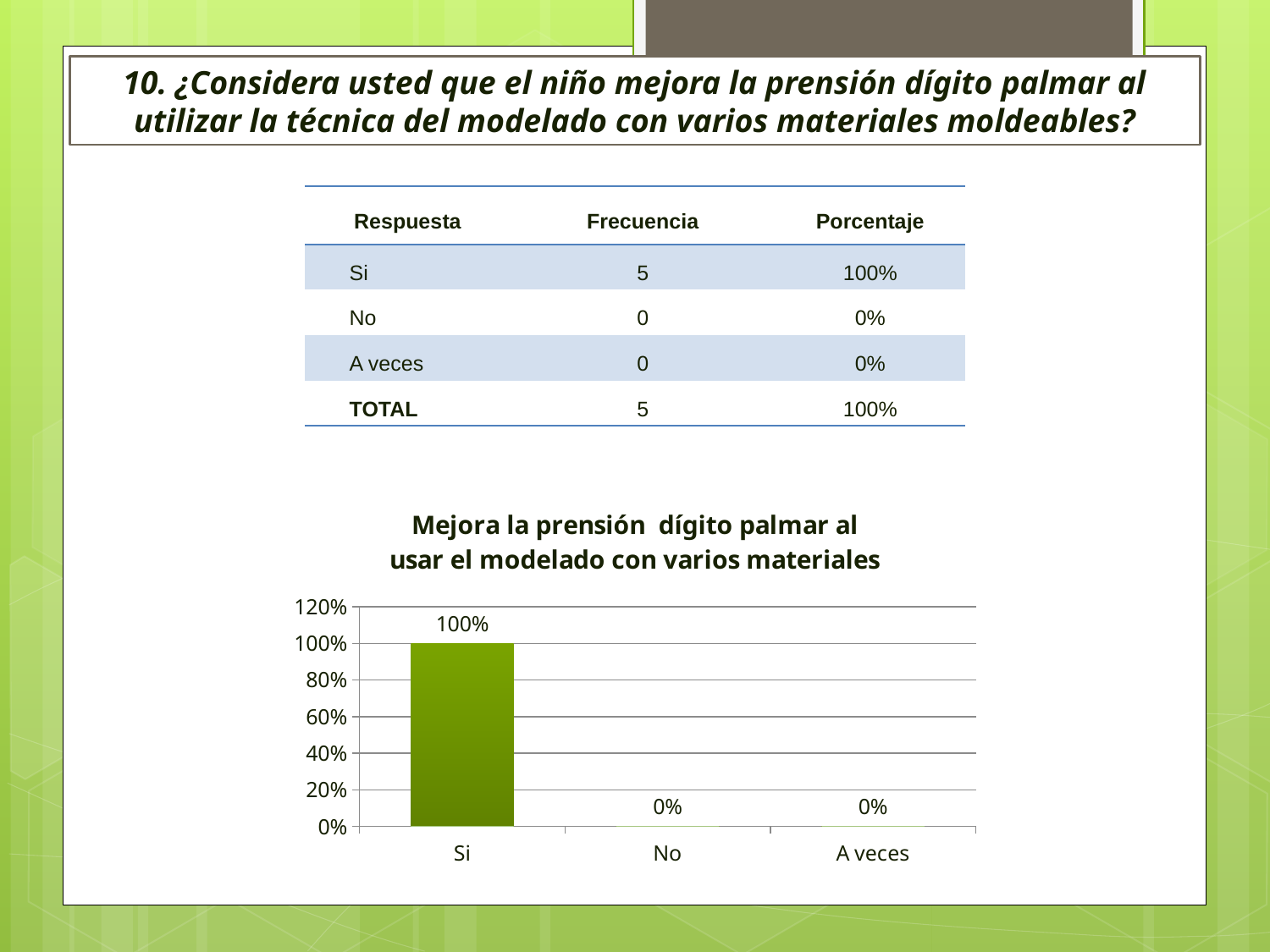
Which is larger, the value for Si or the value for A veces? Si Do the values rise or fall from Si to No along the x axis? fall Which category has the highest value in the chart? Si What is the value for Si in the chart? 100% How many categories are shown on the x axis of the chart? 3 What is the highest tick value shown on the y axis of the chart? 120% What is the value for No in the chart? 0% What is the difference between the values for Si and No? 100% What is the title of the chart? Mejora la prensión dígito palmar al usar el modelado con varios materiales What is the value for A veces in the chart? 0% Is the value for Si greater or less than 80%? greater What kind of chart is shown on the slide? bar chart